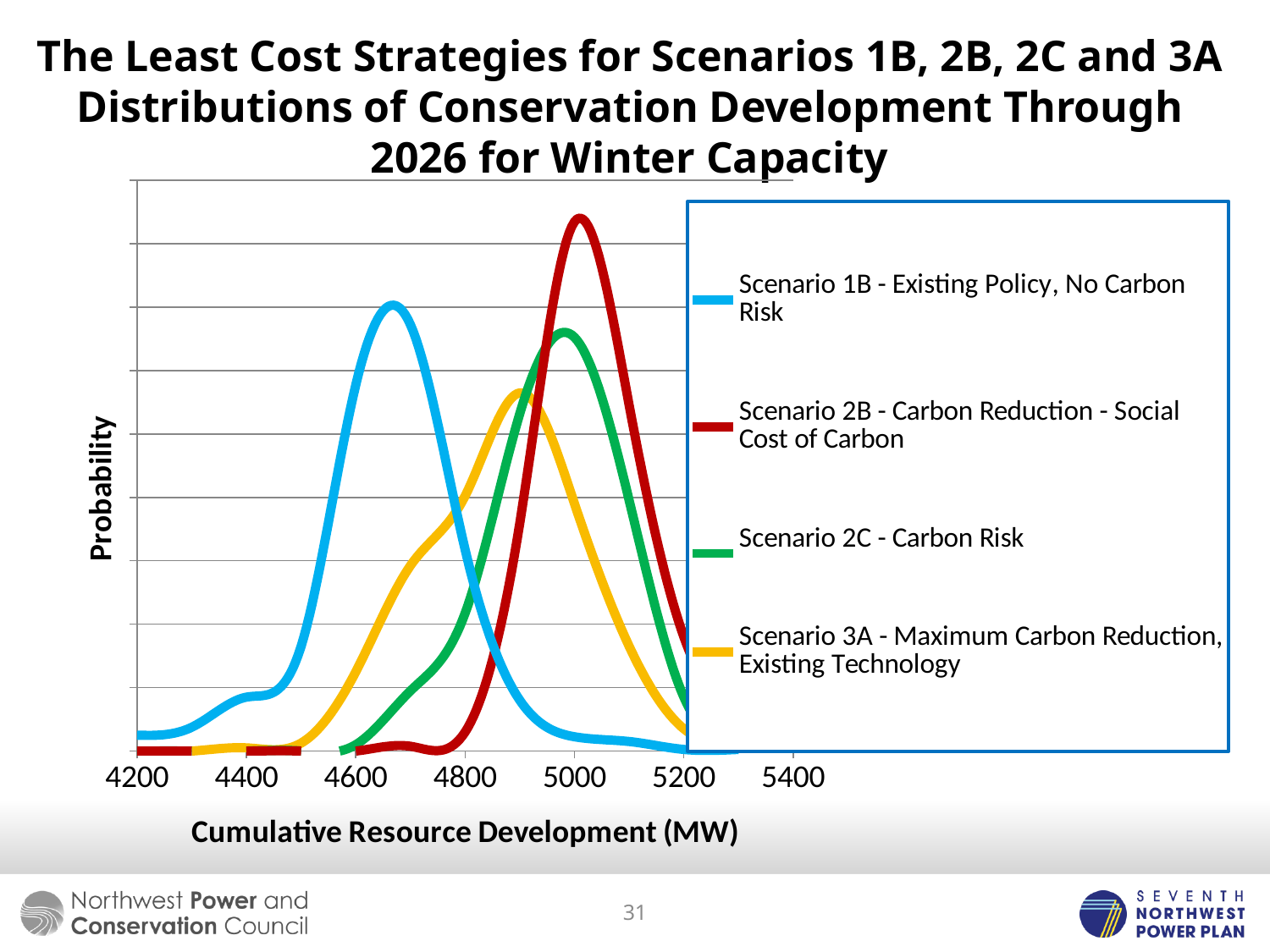
How many series does the legend list? 4 What type of chart is shown on the slide? Line chart Which curve peaks higher, Scenario 1B or Scenario 2C? Scenario 1B Which scenario's curve reaches the highest peak probability? Scenario 2B - Carbon Reduction - Social Cost of Carbon Which scenario's curve peaks at the lowest cumulative resource development (MW)? Scenario 1B - Existing Policy, No Carbon Risk What colour is the line for Scenario 2C - Carbon Risk? Green Is the peak of the Scenario 1B curve at a cumulative resource development greater or less than 4800 MW? less What is the label of the x axis? Cumulative Resource Development (MW) Is the peak of the Scenario 2C curve at a cumulative resource development greater or less than 4800 MW? greater Which scenario's curve has the lowest peak probability? Scenario 3A - Maximum Carbon Reduction, Existing Technology How many tick labels are shown on the x axis? 7 What is the label of the y axis? Probability